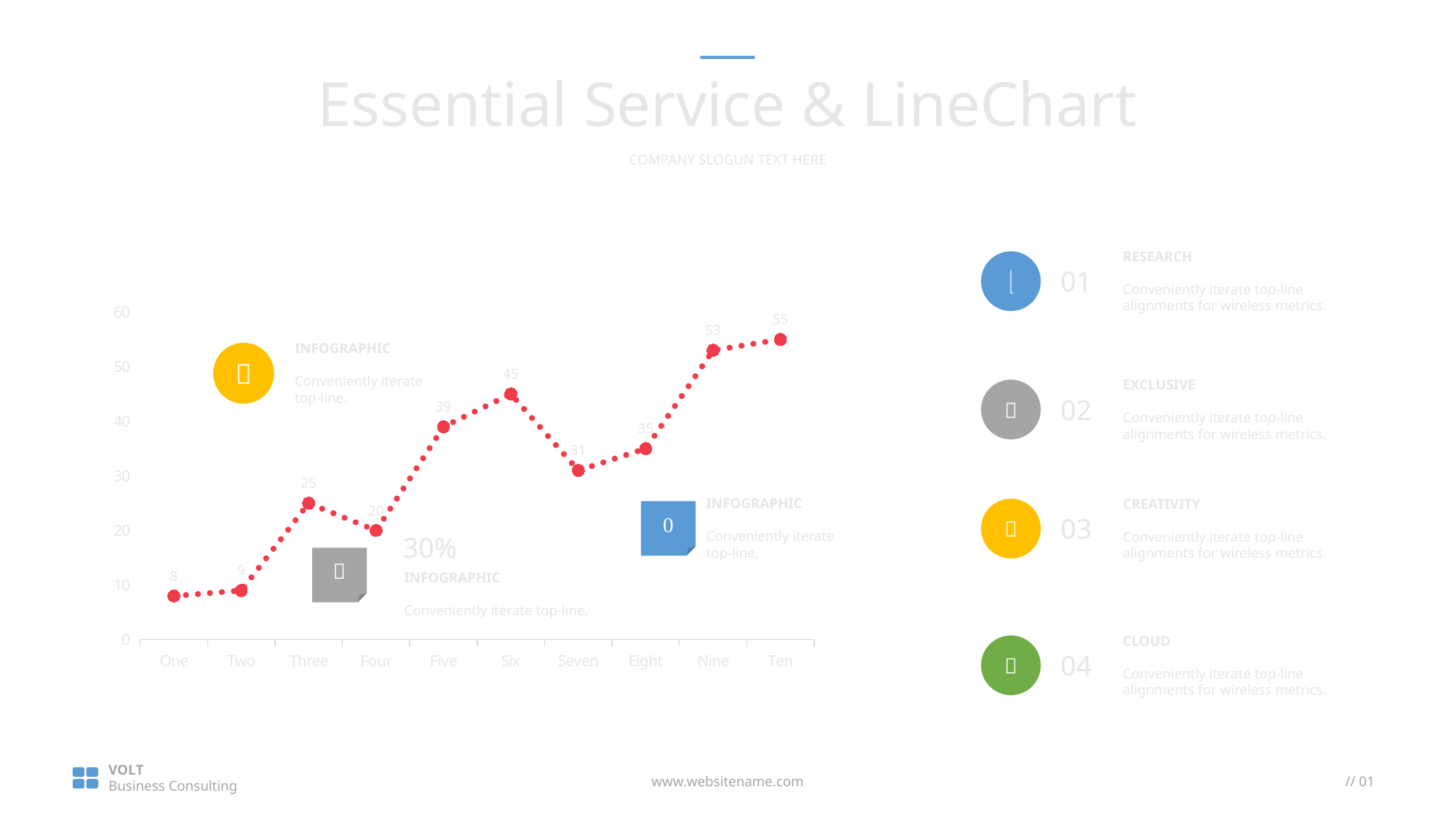
What is the value for Seven? 31 Which category has the highest value? Ten What kind of chart is shown on the slide? line chart Which category has the lowest value? One What is the difference between the values for Six and Seven? 14 Do the values generally rise or fall from One to Ten? rise What is the difference between the values for Ten and One? 47 What is the value for Five? 39 Which is larger, the value for Three or the value for Four? Three What is the value for Nine? 53 How many categories are shown on the x axis? 10 Is the value for Eight greater or less than 40? less